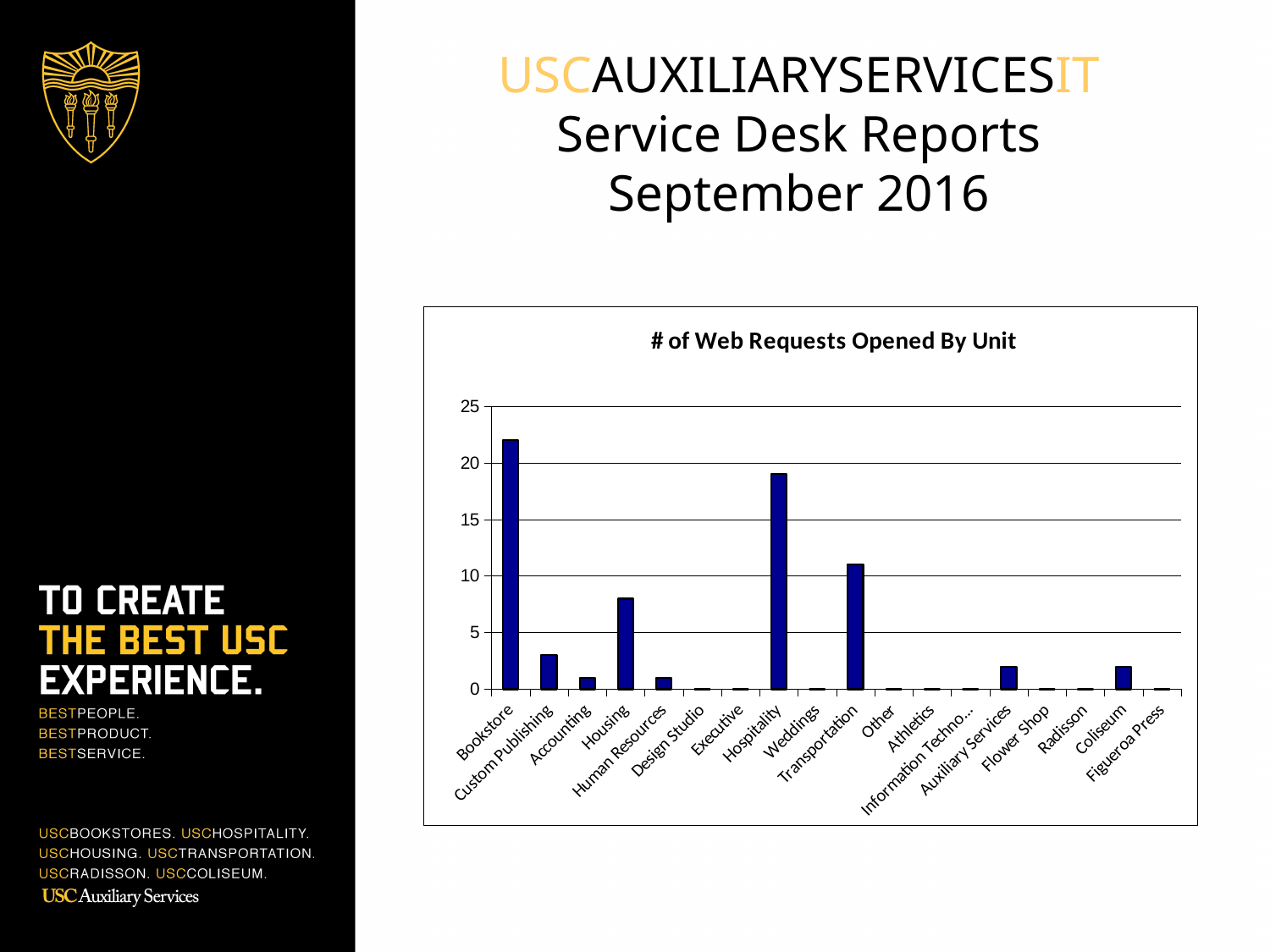
Which has more web requests opened, Housing or Custom Publishing? Housing Is the value for Bookstore greater or less than 20? greater Is the value for Custom Publishing greater or less than 5? less What is the title of the chart? # of Web Requests Opened By Unit Is the value for Housing greater or less than 10? less Which has more web requests opened, Hospitality or Transportation? Hospitality What is the highest value shown on the y axis of the chart? 25 What kind of chart is shown on the slide? bar chart Which unit has the highest number of web requests opened? Bookstore How many units are listed along the x axis of the chart? 18